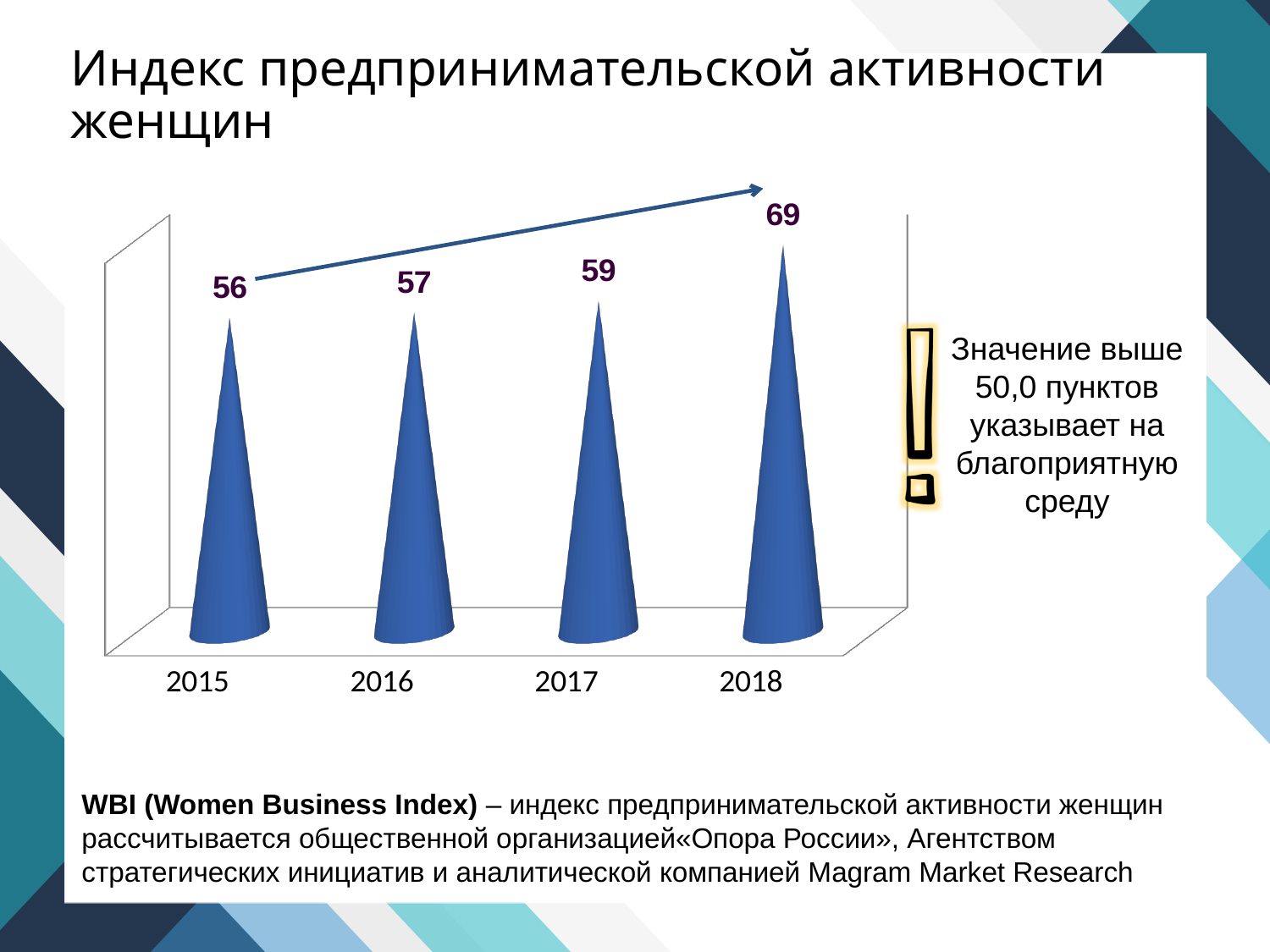
What is the value of the index for 2018? 69 What is the difference between the index values for 2018 and 2017? 10 What is the difference between the index values for 2016 and 2015? 1 What kind of chart is shown on the slide? bar chart Do the index values rise or fall from 2015 to 2018? rise Which year has a larger index value, 2016 or 2018? 2018 What is the title of the slide containing the chart? Индекс предпринимательской активности женщин What is the value of the index for 2017? 59 Which year has the lowest index value? 2015 What is the value of the women's business activity index for 2015? 56 How many years are shown on the chart? 4 Which year has the highest index value? 2018